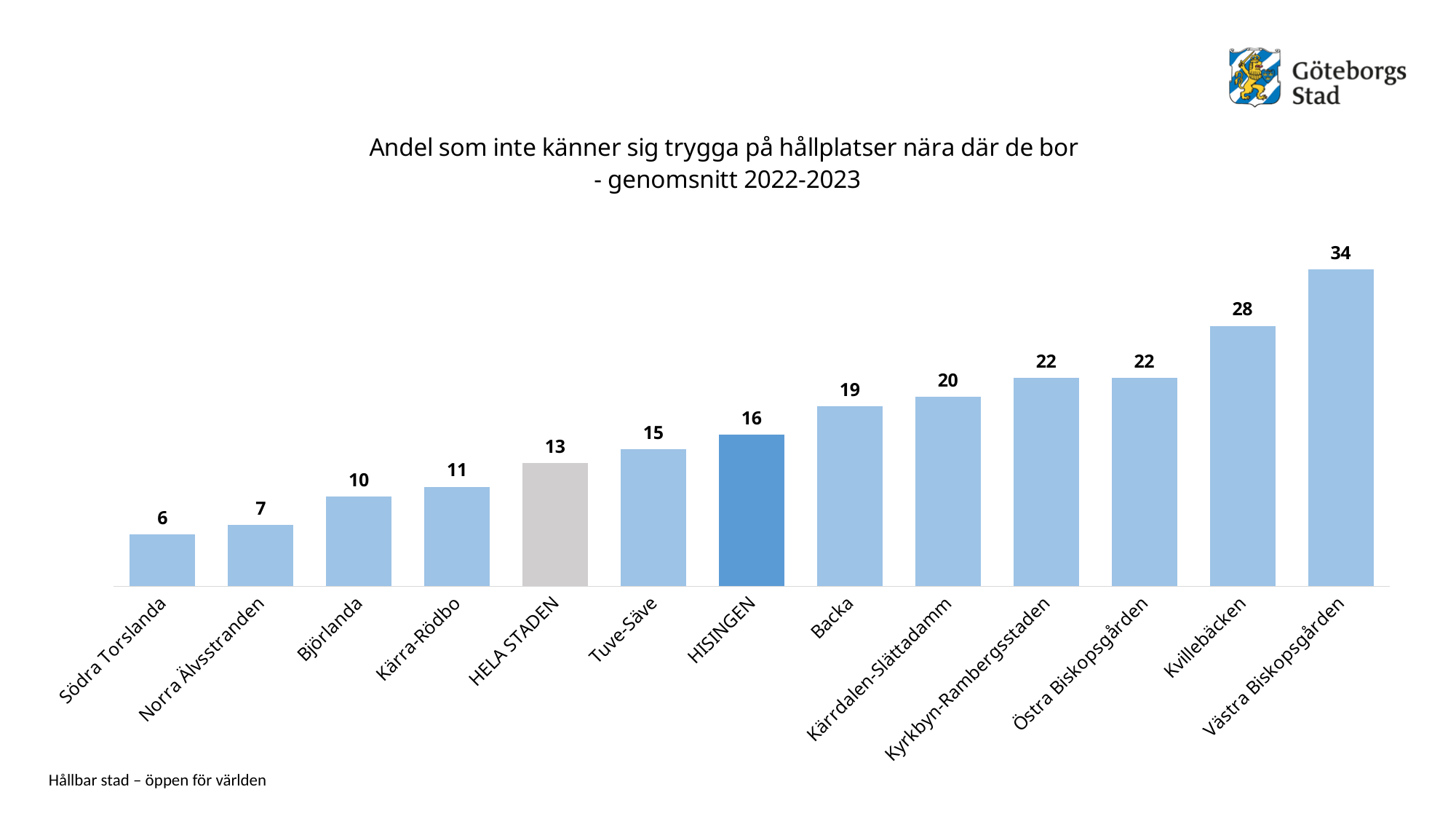
Do the values rise or fall from left to right along the x axis? Rise What is the value for HELA STADEN? 13 Which bar is shown in grey? HELA STADEN What is the value for HISINGEN? 16 How many categories are shown in the chart? 13 What kind of chart is shown on the slide? Bar chart What is the difference between the values for HISINGEN and HELA STADEN? 3 What is the value for Kvillebäcken? 28 Which is larger, the value for Backa or the value for Tuve-Säve? Backa What is the difference between the values for Västra Biskopsgården and Södra Torslanda? 28 Which category has the highest value? Västra Biskopsgården Which category has the lowest value? Södra Torslanda